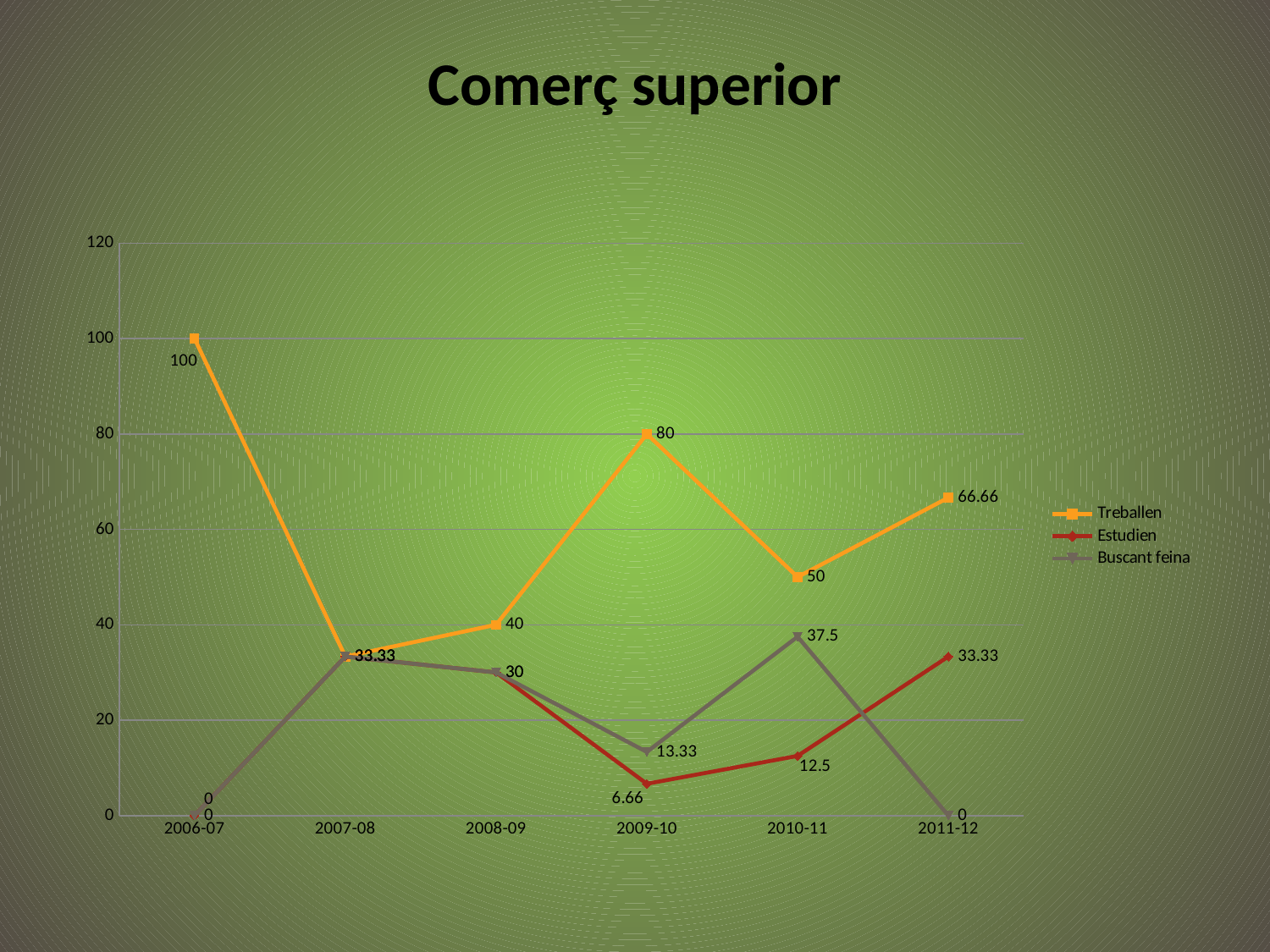
What is the value for Buscant feina in 2010-11? 37.5 What is the difference between the Treballen values in 2009-10 and 2010-11? 30 In which year is the Treballen series lowest? 2007-08 What is the value for Treballen in 2009-10? 80 Is the value for Treballen in 2010-11 greater or less than 40? greater In which year is the Treballen series highest? 2006-07 How many series does the legend list? 3 In 2010-11, which series has the larger value, Buscant feina or Estudien? Buscant feina What kind of chart is shown on the slide? Line chart What is the value for Estudien in 2010-11? 12.5 How many years are shown on the x axis? 6 What is the value for Treballen in 2011-12? 66.66